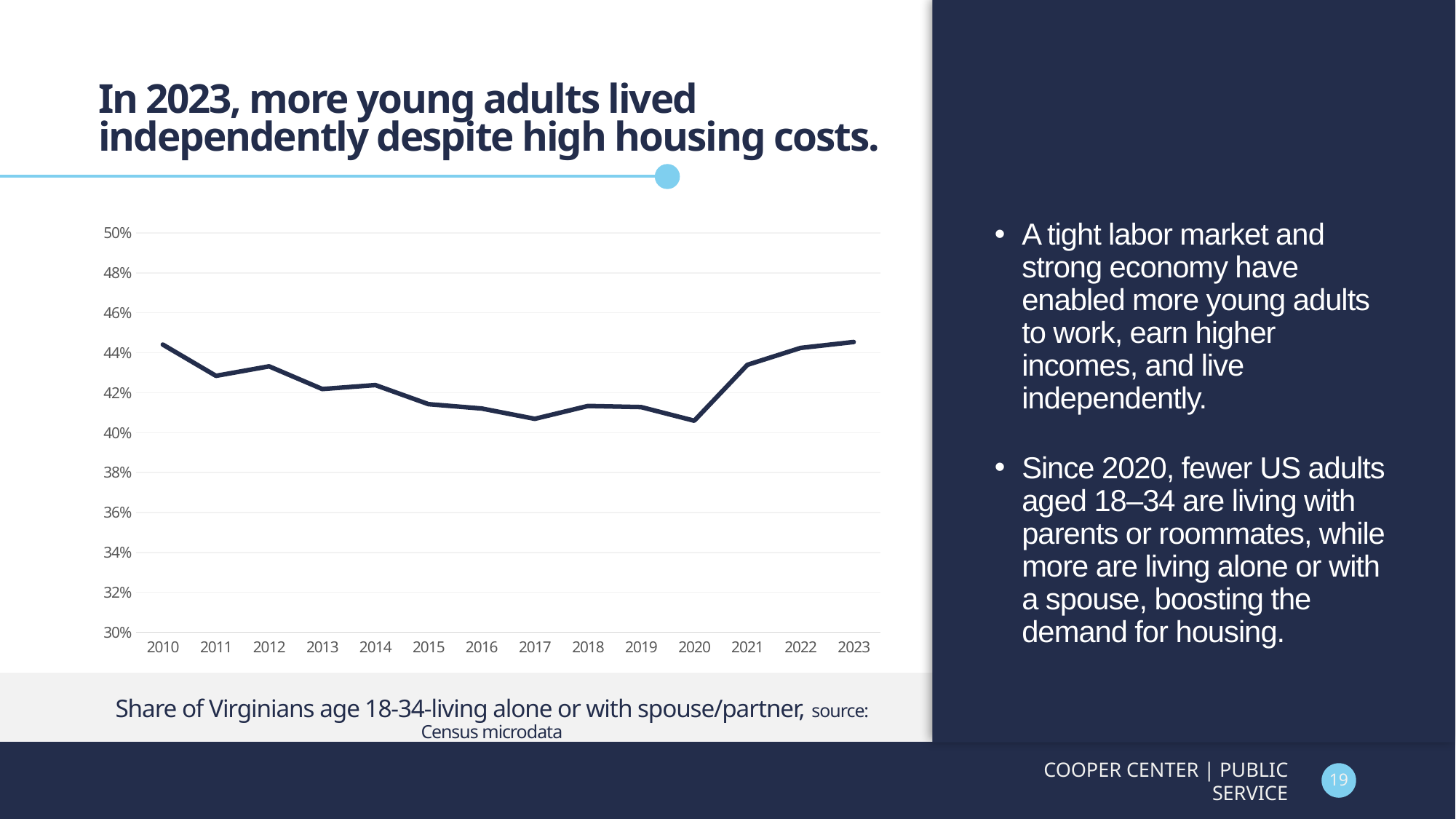
What kind of chart is shown on the slide? line chart What is the first year shown on the x axis of the chart? 2010 Is the value for 2020 greater or less than 42%? less Is the value for 2017 greater or less than 42%? less How many years are plotted along the x axis of the chart? 14 According to the caption, what is the source of the chart's data? Census microdata Is the value for 2010 greater or less than 42%? greater Which year has the larger value, 2010 or 2020? 2010 Which year has the larger value, 2021 or 2020? 2021 Do the values rise or fall from 2020 to 2023? rise